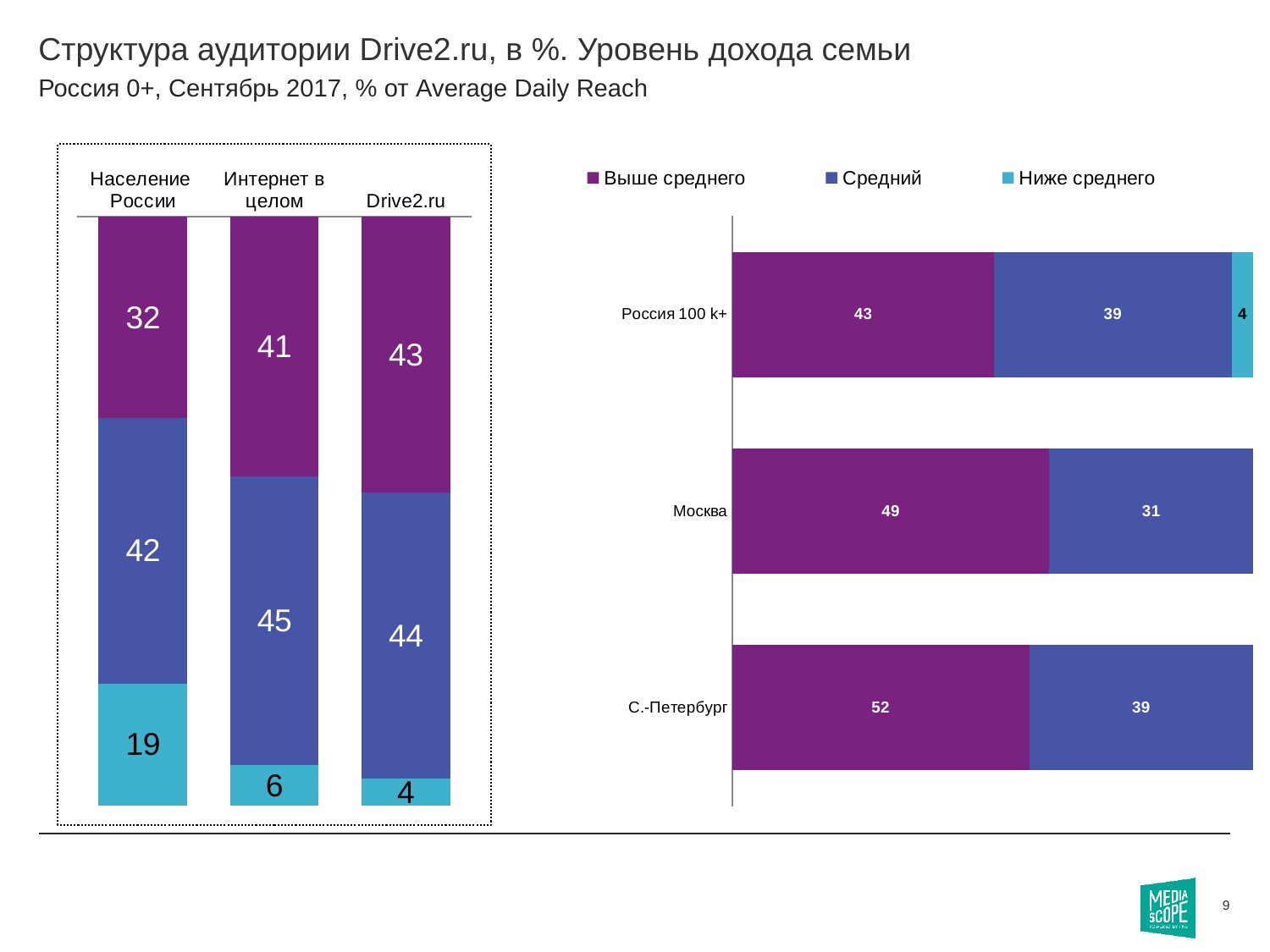
In the left chart, which category has the lowest 'Ниже среднего' value? Drive2.ru Which colour represents 'Ниже среднего' in the legend? light blue (cyan) What type of chart is the left chart? stacked bar chart In the left chart, what is the total of the stacked bar for Интернет в целом? 92 In the left chart, what is the value of the 'Выше среднего' segment for Drive2.ru? 43 How many series does the legend list? 3 In the left chart, what is the difference between the 'Средний' values for Интернет в целом and Население России? 3 In the right chart, what is the 'Средний' value for Москва? 31 How many categories are shown in the right chart? 3 In the right chart, which category has the highest 'Выше среднего' value? С.-Петербург In the left chart, what is the value of the 'Ниже среднего' segment for Население России? 19 In the right chart, which is larger: the 'Выше среднего' value for Москва or for Россия 100 k+? Москва